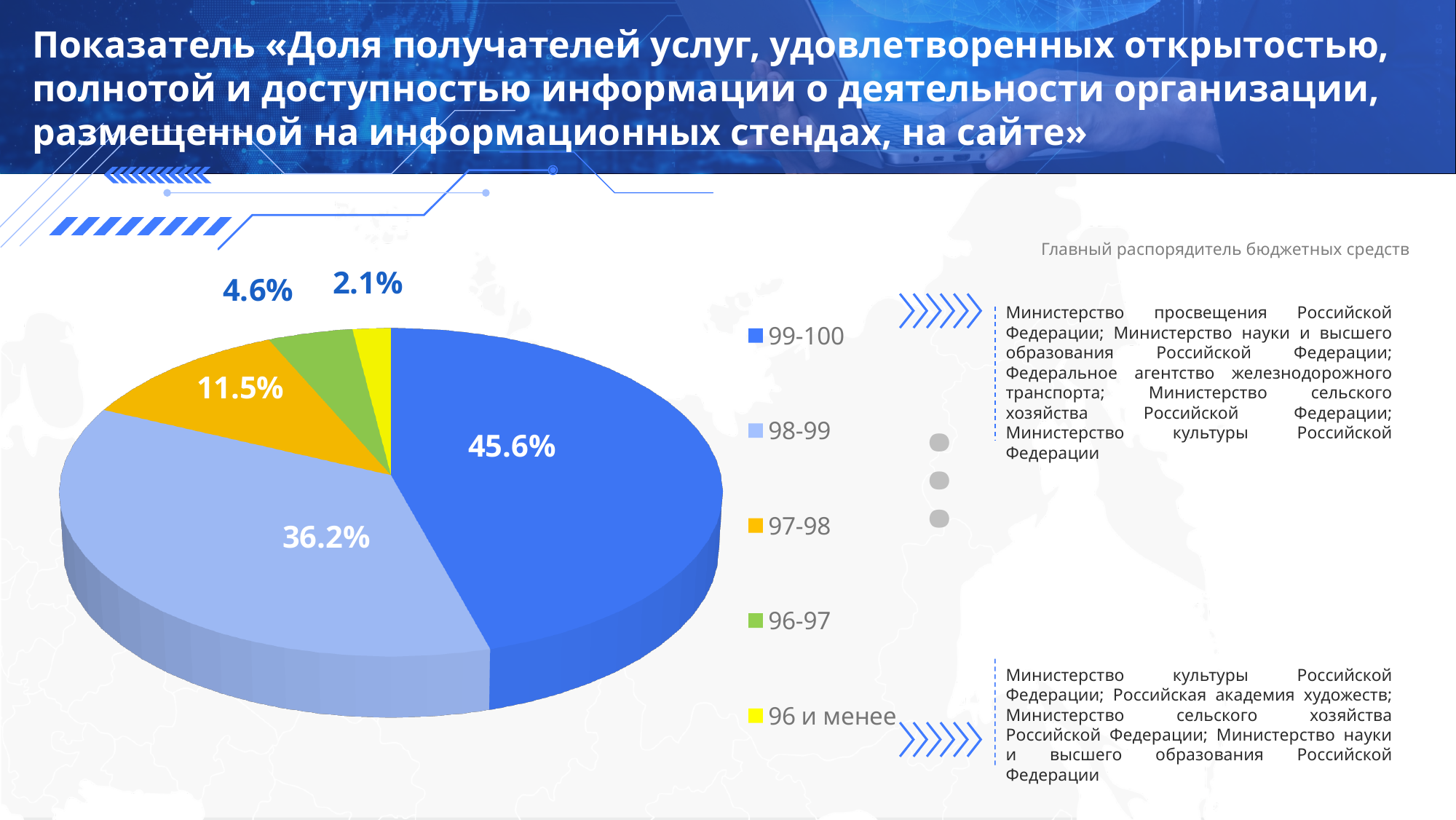
What share of the pie does the "98-99" category hold? 36.2% What is the difference in percentage points between the "99-100" slice and the "98-99" slice? 9.4 What share of the pie does the "97-98" category hold? 11.5% What share of the pie does the "99-100" category hold? 45.6% Which category has the largest slice of the pie? 99-100 Which slice is larger: "97-98" or "96-97"? 97-98 What colour is the slice for the "96 и менее" category? Yellow What type of chart is shown on the slide? Pie chart What share of the pie does the "96 и менее" category hold? 2.1% How many categories are shown in the pie chart? 5 Which category has the smallest slice of the pie? 96 и менее What share of the pie does the "96-97" category hold? 4.6%